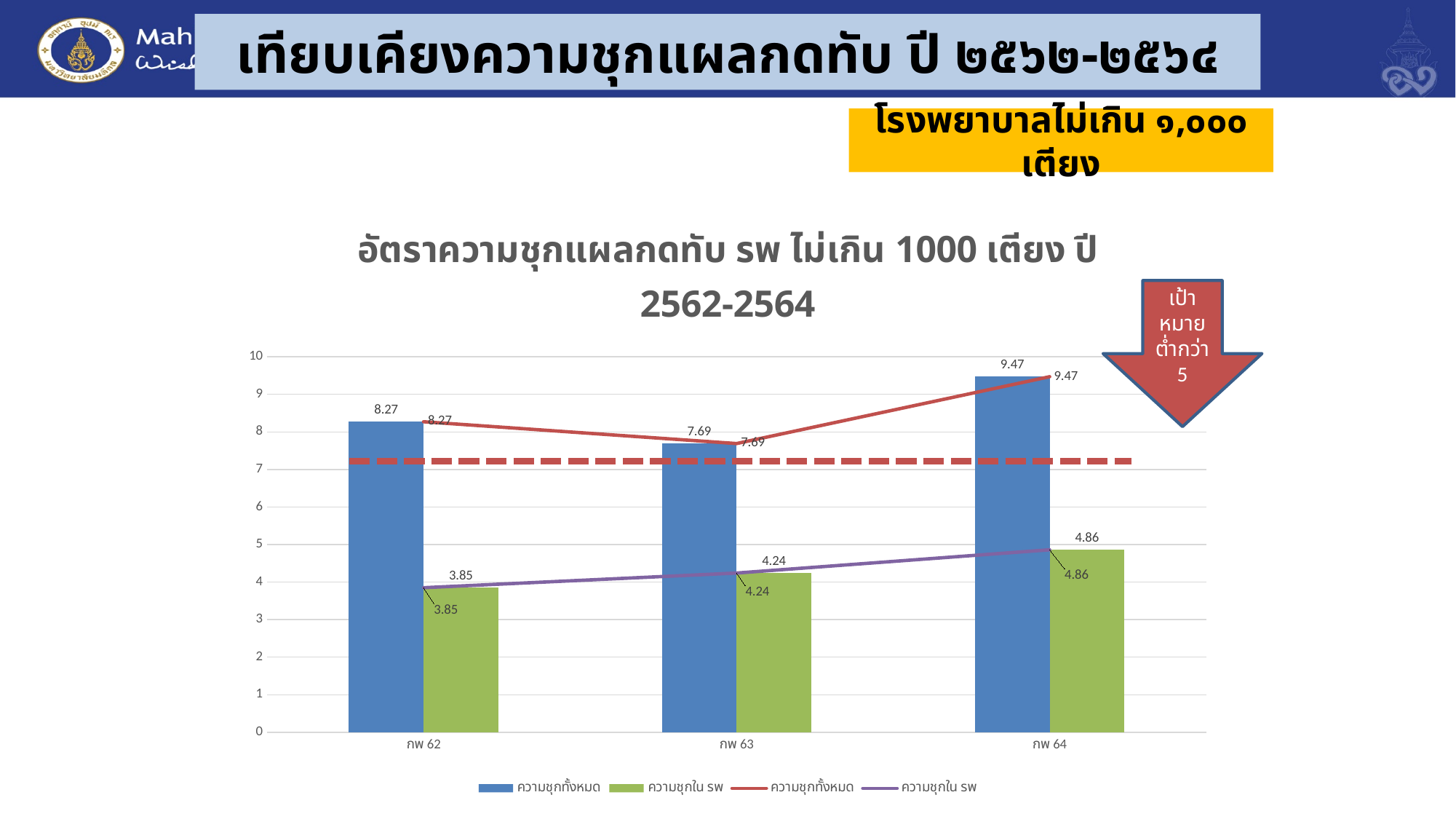
Which category has the lowest value of ความชุกใน รพ? กพ 62 What is the value of ความชุกทั้งหมด for กพ 63? 7.69 What is the value of ความชุกทั้งหมด for กพ 62? 8.27 Which is larger: ความชุกใน รพ for กพ 63 or for กพ 62? กพ 63 Which category has the highest value of ความชุกทั้งหมด? กพ 64 What is the value of ความชุกใน รพ for กพ 64? 4.86 What colour are the bars for ความชุกใน รพ? green How many categories are shown on the x axis? 3 How many series does the legend list? 4 Is the value of ความชุกใน รพ for กพ 64 greater or less than 5? less What is the difference between ความชุกทั้งหมด for กพ 64 and กพ 63? 1.78 Does ความชุกใน รพ rise or fall from กพ 62 to กพ 64? rise